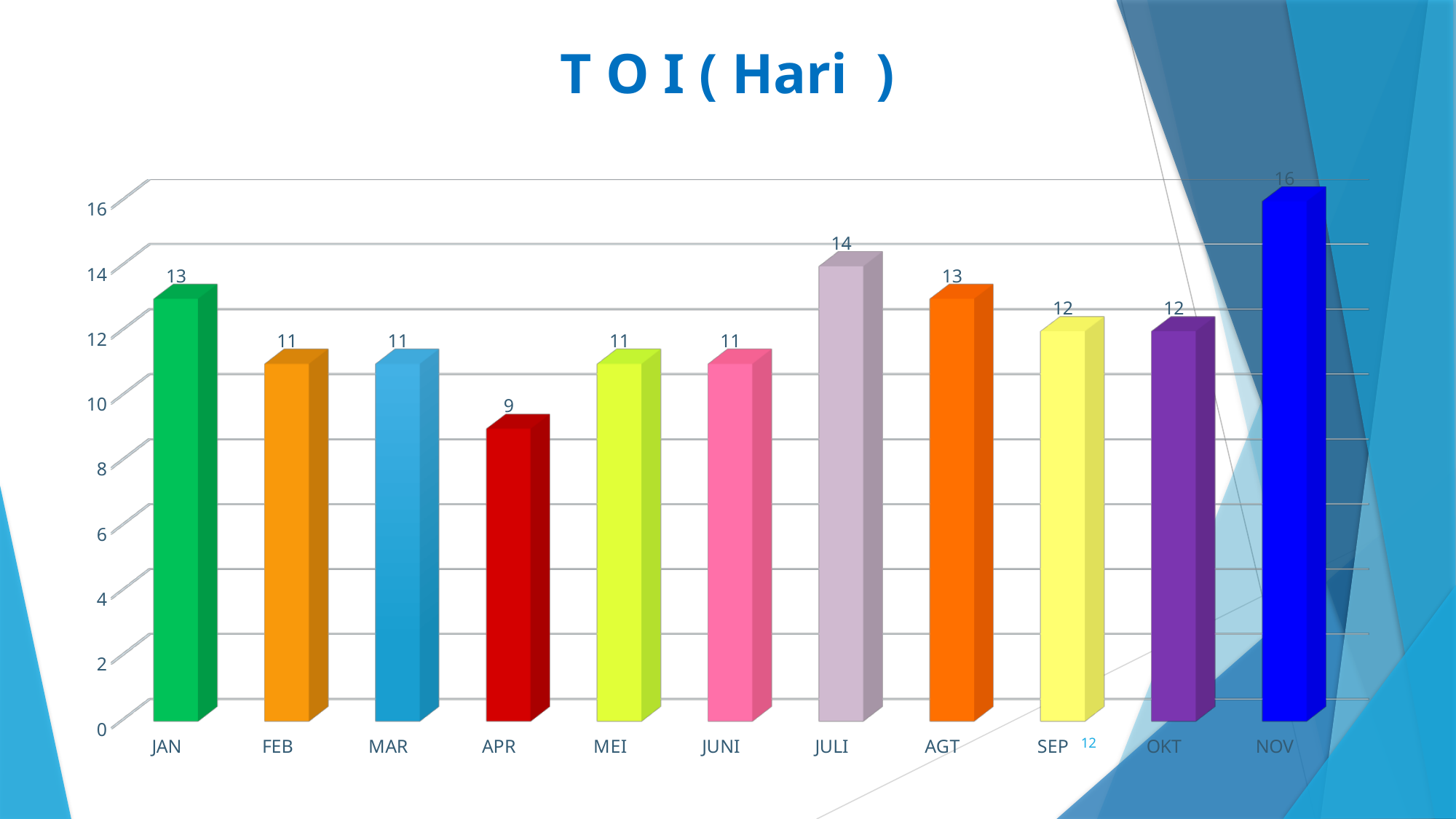
What is the title of the chart? T O I ( Hari ) What is the difference between the values for NOV and APR? 7 What is the value for NOV? 16 What kind of chart is shown on the slide? Bar chart What is the value for JULI? 14 How many months are shown on the x axis? 11 What is the value for APR? 9 Which is larger, the value for JULI or the value for AGT? JULI Which month has the highest value? NOV What is the value for JAN? 13 Is the value for SEP greater or less than 10? greater Which month has the lowest value? APR